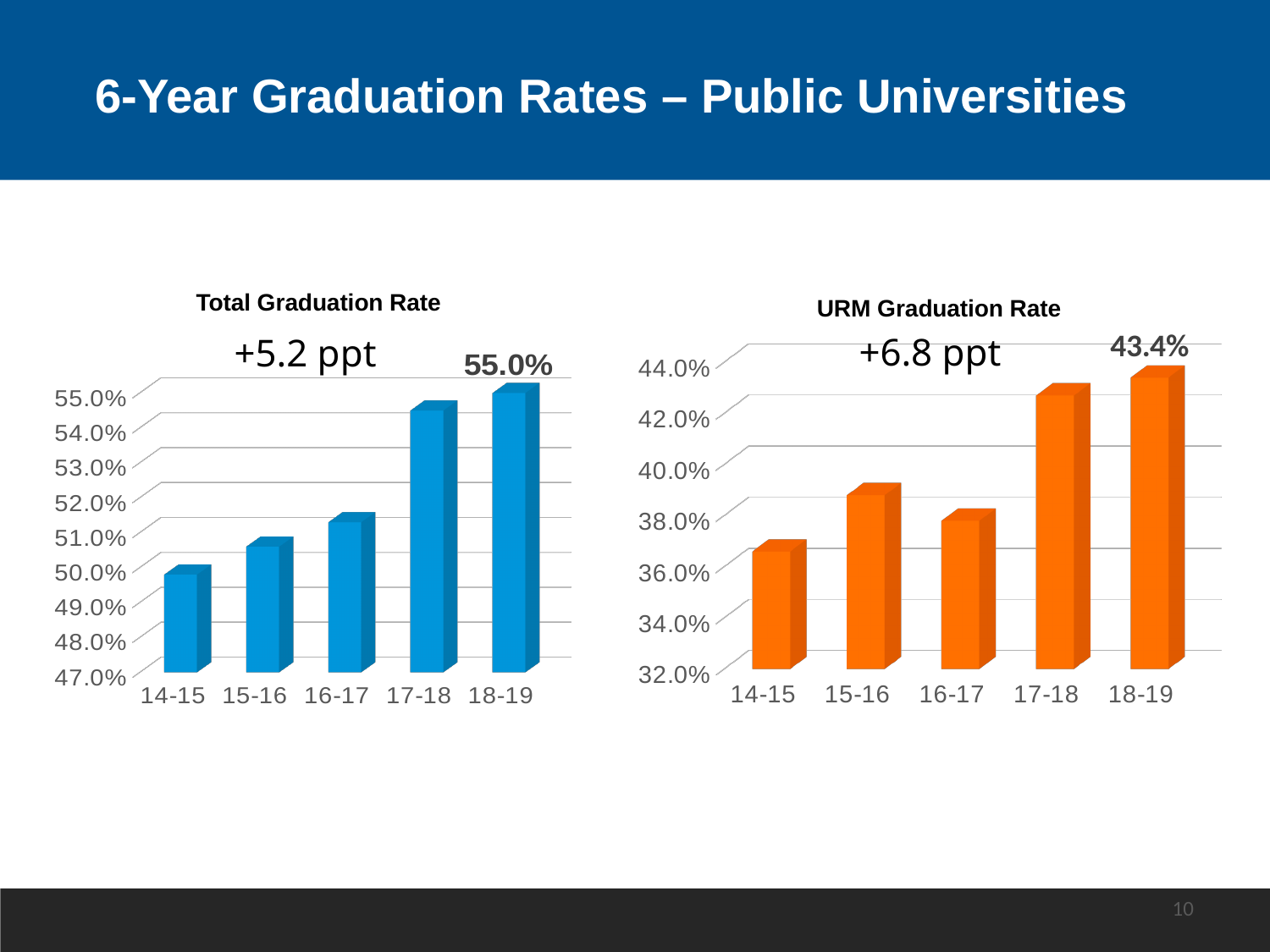
In the URM Graduation Rate chart, which is larger, the value for 15-16 or the value for 16-17? 15-16 In the URM Graduation Rate chart, what is the value for 18-19? 43.4% In the Total Graduation Rate chart, is the value for 14-15 greater or less than 51.0%? less In the Total Graduation Rate chart, which year has the highest graduation rate? 18-19 How many years are shown on the x axis of the URM Graduation Rate chart? 5 In the URM Graduation Rate chart, which year has the lowest graduation rate? 14-15 In the URM Graduation Rate chart, is the value for 17-18 greater or less than 40.0%? greater What change in percentage points is annotated on the URM Graduation Rate chart? +6.8 ppt In the Total Graduation Rate chart, which year has the lowest graduation rate? 14-15 In the Total Graduation Rate chart, is the value for 17-18 greater or less than 53.0%? greater What kind of chart is the Total Graduation Rate chart? bar chart In the Total Graduation Rate chart, what is the value for 18-19? 55.0%